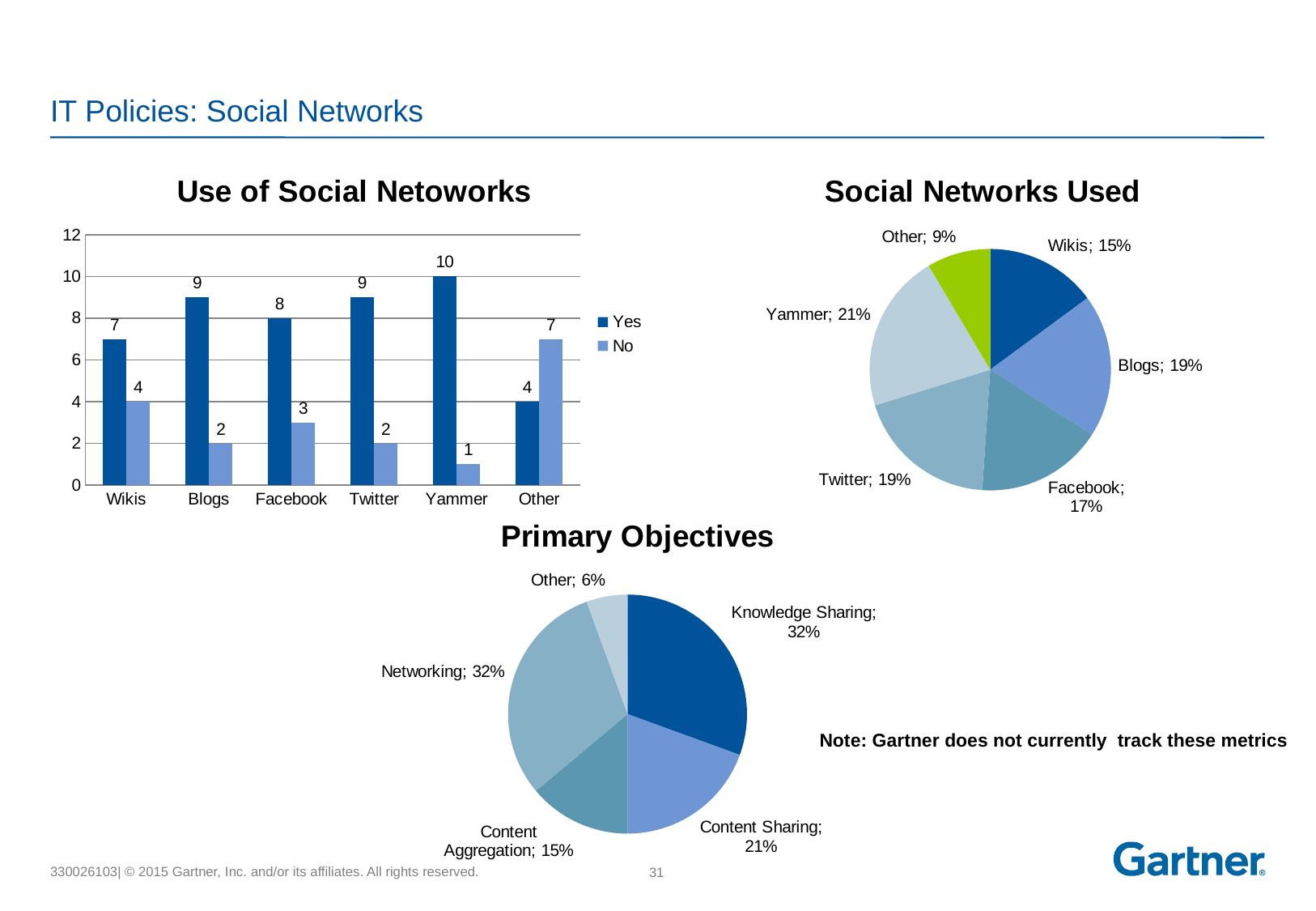
In the 'Use of Social Netoworks' chart, what is the difference between the Yes and No values for Facebook? 5 In the 'Use of Social Netoworks' chart, what is the No value for Other? 7 What kind of chart is 'Use of Social Netoworks'? Bar chart In the 'Use of Social Netoworks' chart, is the Yes value for Wikis larger or the No value for Wikis? Yes In the 'Social Networks Used' pie chart, which slice is the smallest? Other How many categories are shown on the x axis of the 'Use of Social Netoworks' chart? 6 How many series does the legend of the 'Use of Social Netoworks' chart list? 2 In the 'Use of Social Netoworks' chart, which category has the highest Yes value? Yammer In the 'Primary Objectives' pie chart, what share does Content Aggregation have? 15% In the 'Social Networks Used' pie chart, what share does Yammer have? 21% In the 'Use of Social Netoworks' chart, what is the Yes value for Yammer? 10 In the 'Use of Social Netoworks' chart, which category has the lowest No value? Yammer